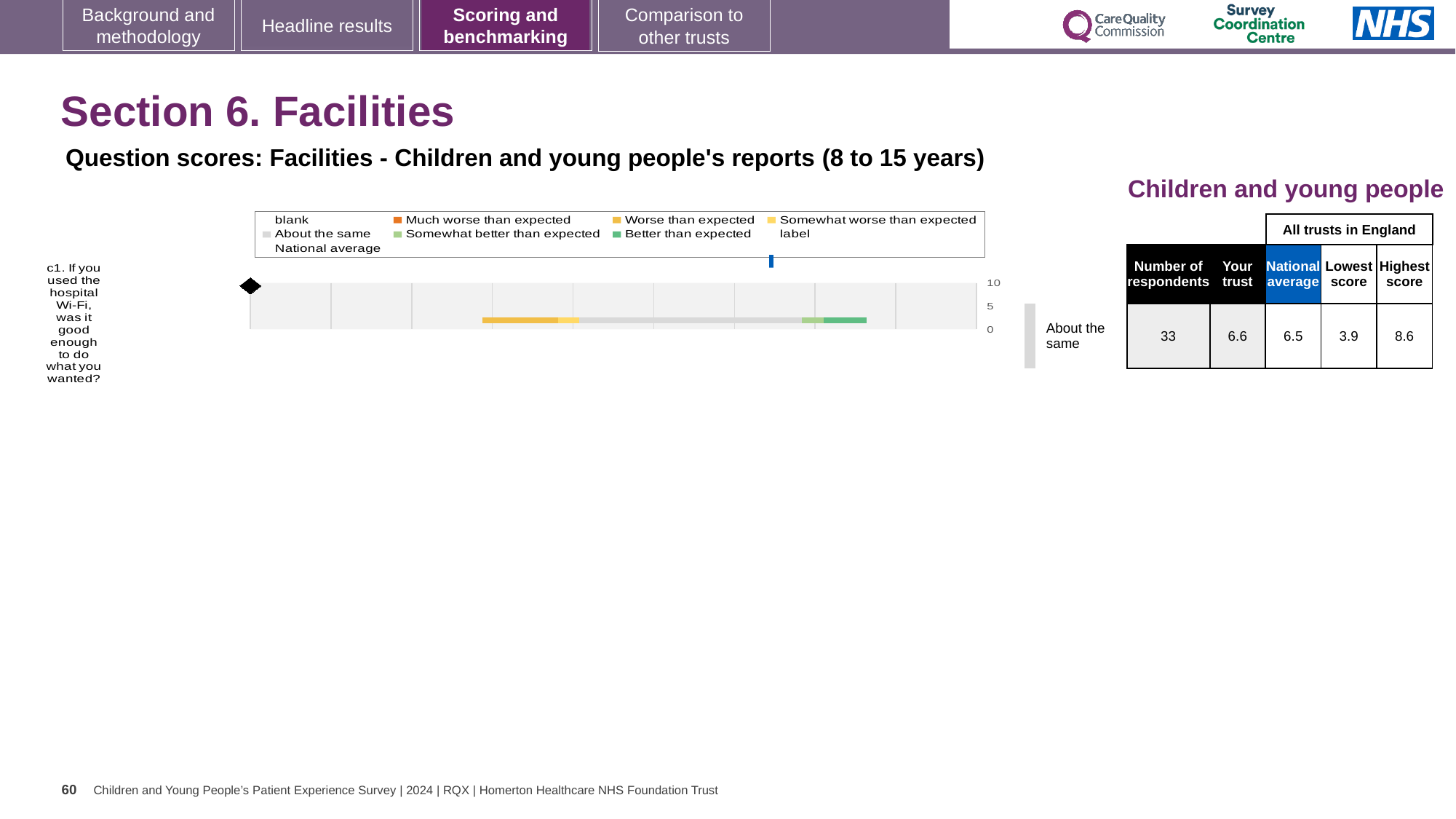
What benchmark category is the trust's result for question c1 labelled as next to the chart? About the same How many survey questions are plotted in the chart on this slide? 1 How many respondents answered question c1 about hospital Wi-Fi, according to the table beside the chart? 33 According to the table beside the chart, what is the 'Your trust' score for question c1 about hospital Wi-Fi? 6.6 What is the difference between the highest score (8.6) and the lowest score (3.9) for question c1? 4.7 What kind of chart is used to show the question score for c1 on this slide? bar chart What is the highest value shown on the chart's score axis? 10 According to the table beside the chart, what is the highest score among all trusts in England for question c1? 8.6 According to the table beside the chart, what is the national average score for question c1 about hospital Wi-Fi? 6.5 For question c1, which is larger: the 'Your trust' score or the national average score? Your trust According to the table beside the chart, what is the lowest score among all trusts in England for question c1? 3.9 Which colour does the chart legend use for 'Much worse than expected'? orange